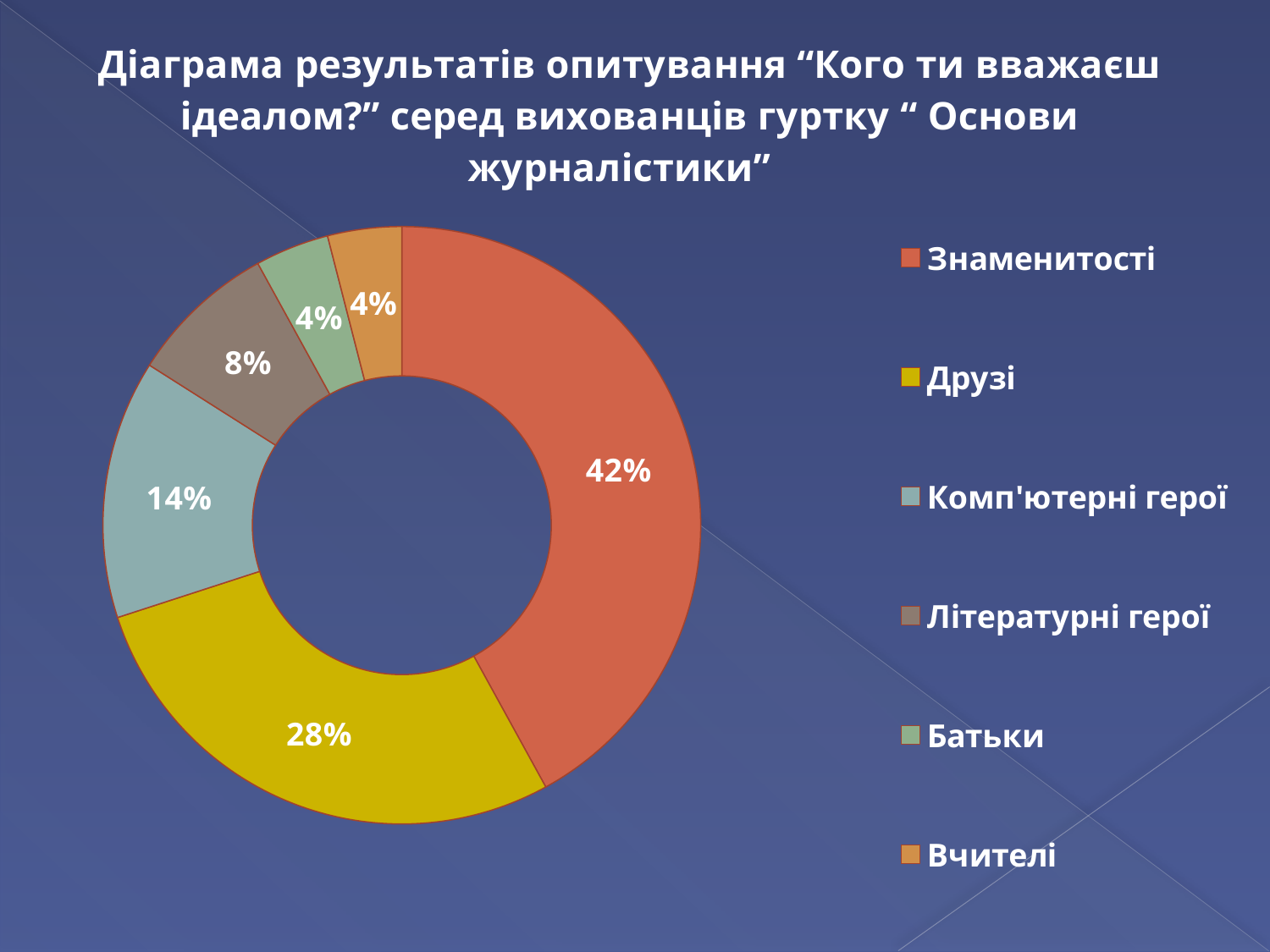
Which two categories share the smallest value on the chart? Батьки and Вчителі Which is larger, the share for Друзі or the share for Комп'ютерні герої? Друзі What type of chart is shown on the slide? Doughnut (pie) chart What share of respondents chose Знаменитості? 42% What percentage is shown for Літературні герої? 8% What is the difference in percentage points between Знаменитості and Друзі? 14 How many categories does the chart show? 6 Which category has the largest share of the chart? Знаменитості What percentage is shown for Друзі? 28% What is the difference in percentage points between Комп'ютерні герої and Літературні герої? 6 What colour is the segment for Друзі? Yellow What is the value for Комп'ютерні герої? 14%